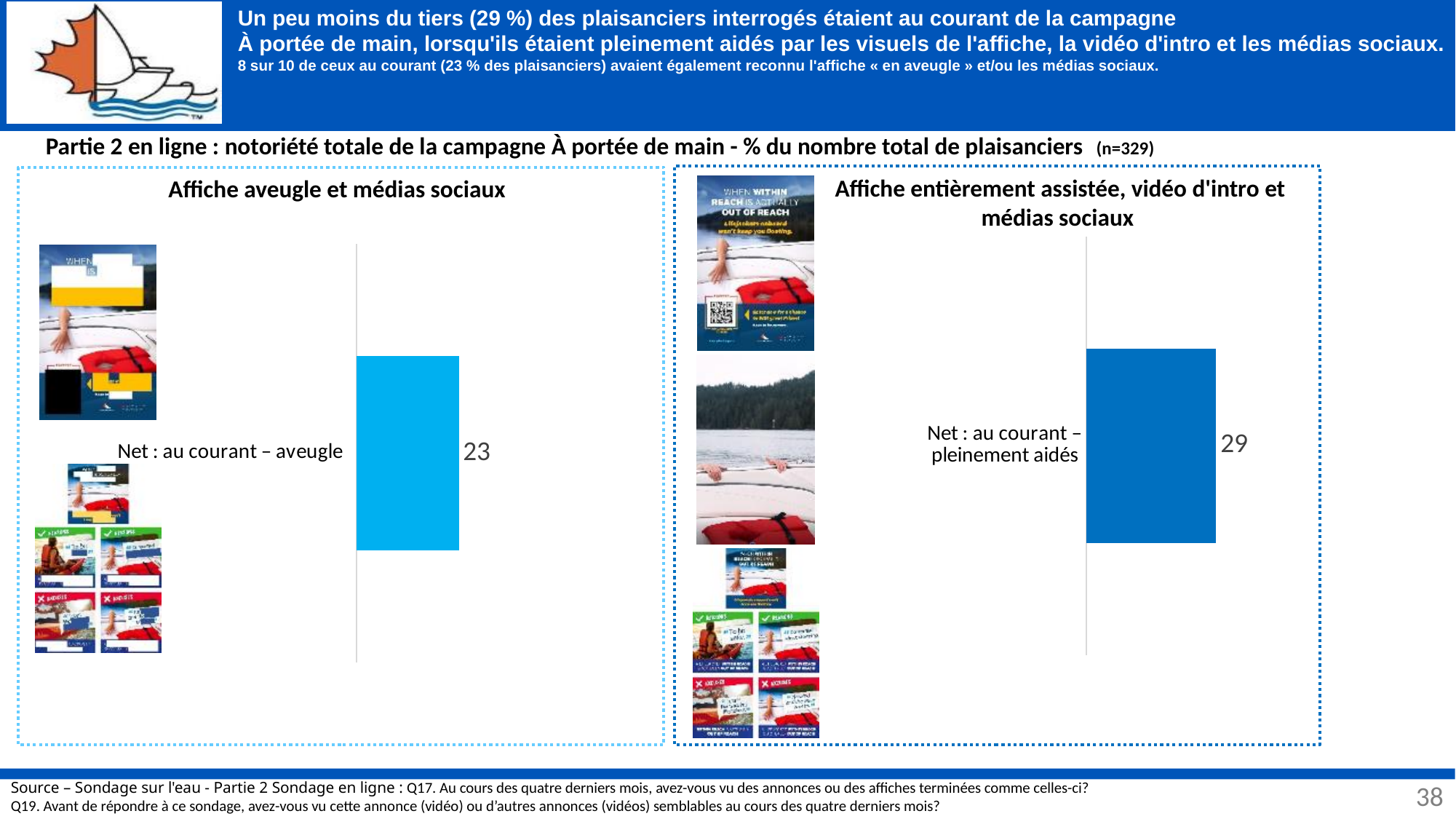
In the right chart titled "Affiche entièrement assistée, vidéo d'intro et médias sociaux", what is the value for "Net : au courant – pleinement aidés"? 29 How many bars are plotted in the left chart titled "Affiche aveugle et médias sociaux"? 1 What is the difference between the value in the right chart ("Net : au courant – pleinement aidés") and the value in the left chart ("Net : au courant – aveugle")? 6 What kind of chart is the left chart titled "Affiche aveugle et médias sociaux"? Bar chart In the left chart titled "Affiche aveugle et médias sociaux", what is the value for "Net : au courant – aveugle"? 23 Which is larger: the value for "Net : au courant – aveugle" in the left chart or the value for "Net : au courant – pleinement aidés" in the right chart? Net : au courant – pleinement aidés How many bars are plotted in the right chart titled "Affiche entièrement assistée, vidéo d'intro et médias sociaux"? 1 What kind of chart is the right chart titled "Affiche entièrement assistée, vidéo d'intro et médias sociaux"? Bar chart What is the category label of the bar in the left chart titled "Affiche aveugle et médias sociaux"? Net : au courant – aveugle What is the title of the chart on the right side of the slide? Affiche entièrement assistée, vidéo d'intro et médias sociaux